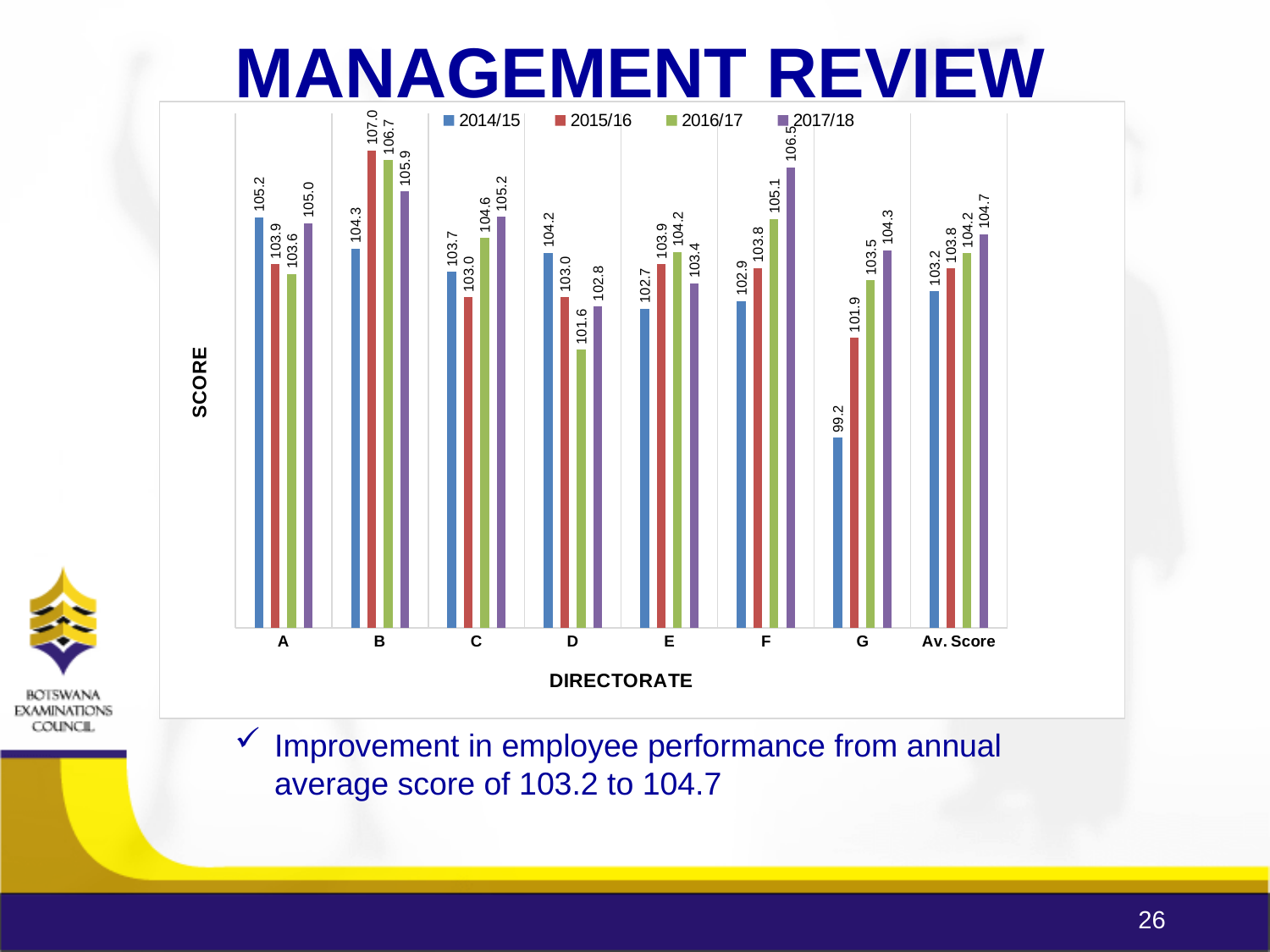
How many categories are shown on the x axis? 8 How many series does the legend list? 4 What is the 2015/16 score for directorate B? 107.0 Which directorate has the highest 2015/16 score? B What is the 2017/18 value for Av. Score? 104.7 Which directorate has the lowest 2014/15 score? G Which is larger for directorate F: the 2016/17 score or the 2017/18 score? 2017/18 Do the Av. Score values rise or fall from 2014/15 to 2017/18? Rise What is the 2016/17 score for directorate D? 101.6 What kind of chart is shown on the slide? Bar chart What is the difference between the 2017/18 and 2014/15 scores for directorate G? 5.1 What is the 2014/15 score for directorate A? 105.2